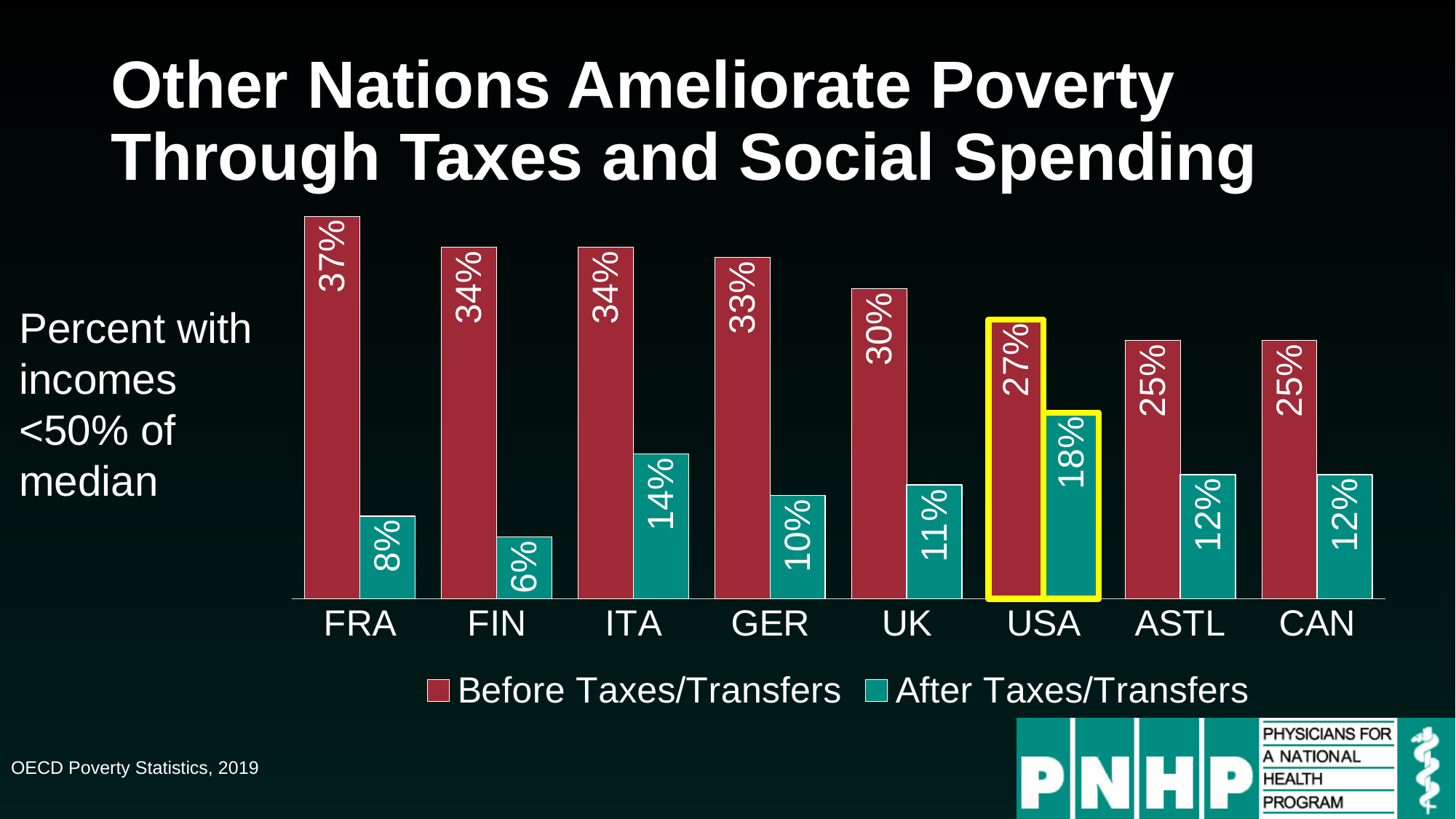
What is the Before Taxes/Transfers value for FRA? 37% What is the difference between the Before and After Taxes/Transfers values for USA? 9% Which country has the highest After Taxes/Transfers value? USA Which country has the highest Before Taxes/Transfers value? FRA How many series does the legend list? 2 How many countries are shown on the x axis? 8 What is the After Taxes/Transfers value for FIN? 6% What is the difference between the Before and After Taxes/Transfers values for FRA? 29% Which country has the lowest After Taxes/Transfers value? FIN What is the After Taxes/Transfers value for USA? 18% Which is larger, the After Taxes/Transfers value for ITA or for GER? ITA What kind of chart is shown on the slide? Bar chart